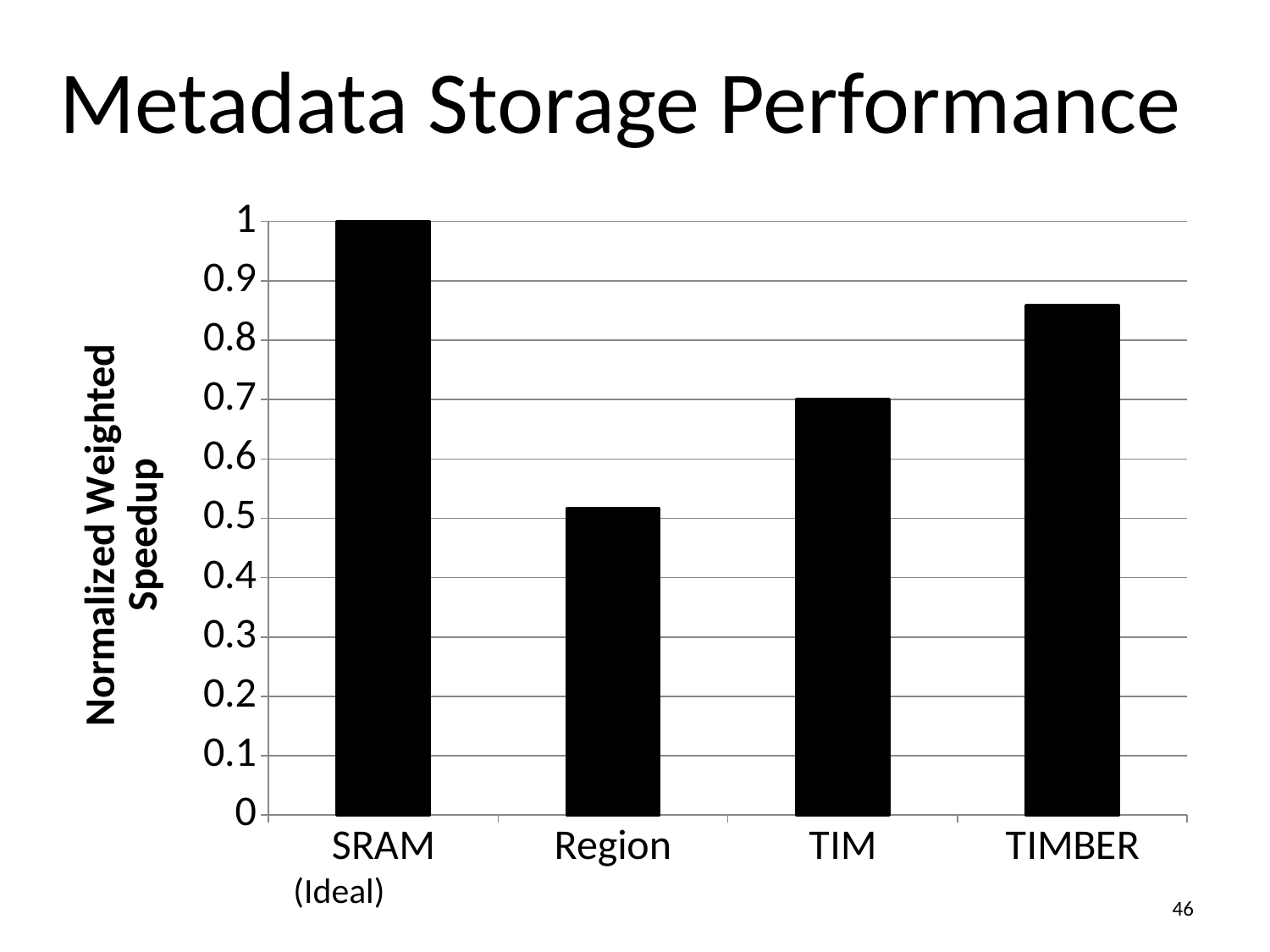
Which has a higher normalized weighted speedup, Region or TIM? TIM What is the normalized weighted speedup for SRAM (Ideal)? 1 Is the value for Region greater or less than 0.6? less Which category has the highest normalized weighted speedup? SRAM (Ideal) Is the value for TIMBER greater or less than 0.9? less How many bars (categories) are shown in the chart? 4 Is the value for TIMBER greater or less than 0.8? greater What type of chart is shown on the slide? bar chart Which category has the lowest normalized weighted speedup? Region What is the label of the vertical axis? Normalized Weighted Speedup Which has a higher normalized weighted speedup, TIM or TIMBER? TIMBER